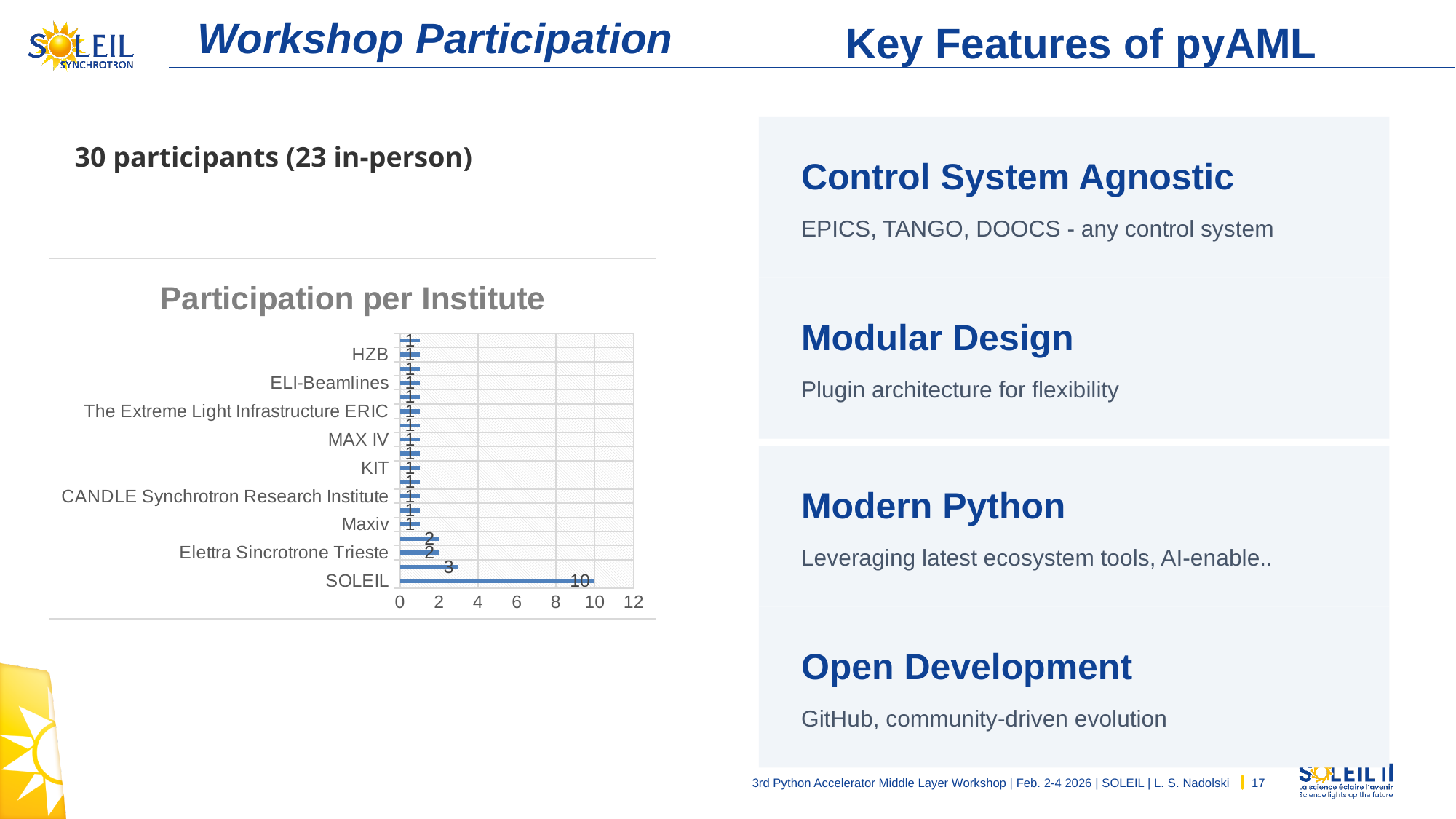
In the 'Participation per Institute' chart, which institute has the highest participation? SOLEIL In the 'Participation per Institute' chart, what is the value for KIT? 1 In the 'Participation per Institute' chart, what is the value for Maxiv? 1 In the 'Participation per Institute' chart, what is the value for Elettra Sincrotrone Trieste? 2 In the 'Participation per Institute' chart, what is the value for HZB? 1 In the 'Participation per Institute' chart, what is the difference between the values for SOLEIL and Elettra Sincrotrone Trieste? 8 What kind of chart is 'Participation per Institute'? bar chart What is the title of the chart on the slide? Participation per Institute In the 'Participation per Institute' chart, what is the value for SOLEIL? 10 In the 'Participation per Institute' chart, which is larger, the value for SOLEIL or the value for MAX IV? SOLEIL In the 'Participation per Institute' chart, is the value for CANDLE Synchrotron Research Institute greater or less than 2? less In the 'Participation per Institute' chart, is the value for SOLEIL greater or less than 8? greater